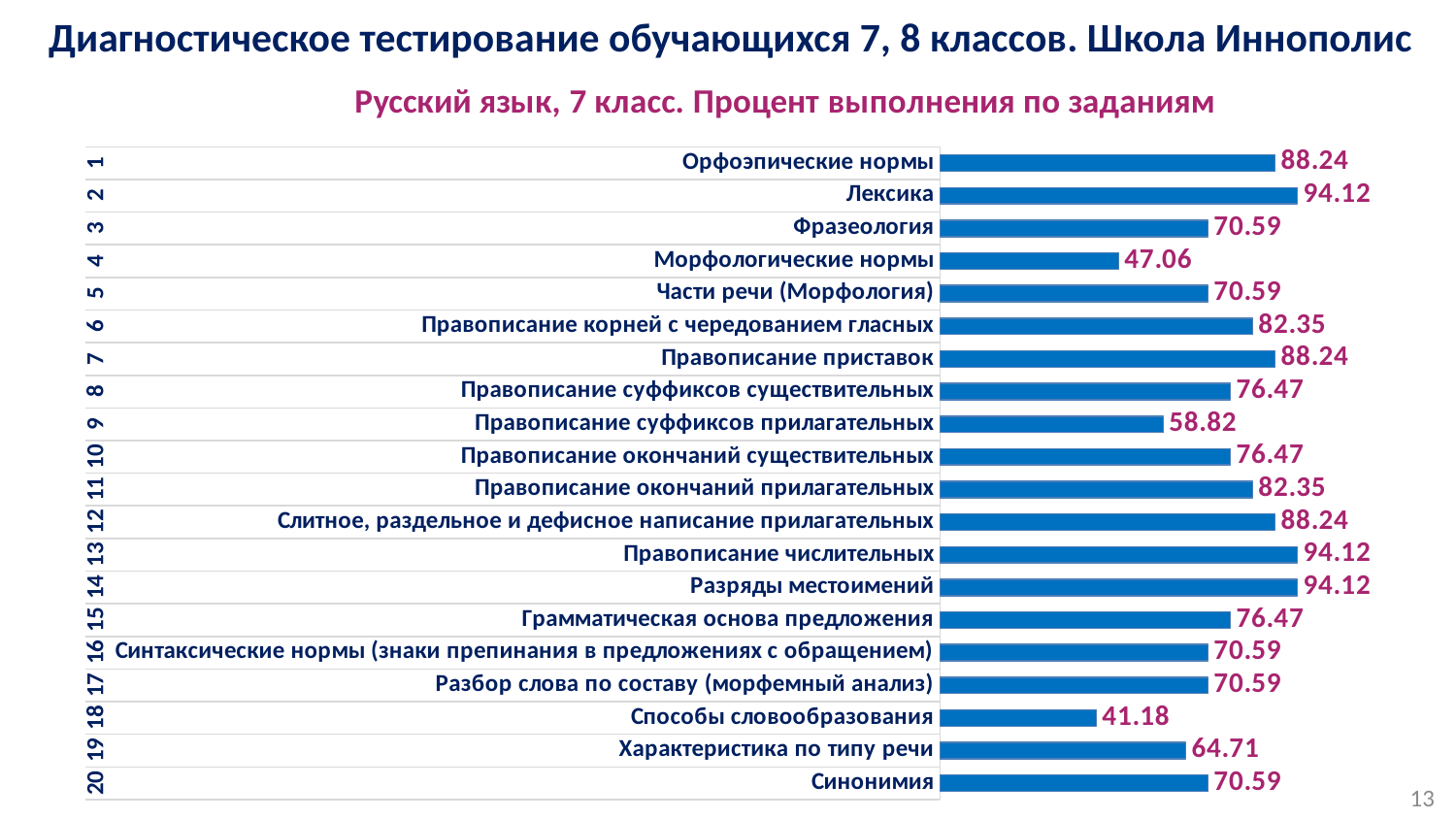
What is the value for Морфологические нормы? 47.06 How many categories are shown in the chart? 20 What is the value for Характеристика по типу речи? 64.71 What is the title of the chart? Русский язык, 7 класс. Процент выполнения по заданиям What is the highest value shown in the chart? 94.12 What is the value for Синонимия? 70.59 What is the value for Правописание суффиксов прилагательных? 58.82 What is the difference between the values for Орфоэпические нормы and Фразеология? 17.65 What is the difference between the values for Лексика and Способы словообразования? 52.94 What type of chart is shown on the slide? bar chart Which category has the lowest value? Способы словообразования Which is larger, the value for Правописание приставок or the value for Правописание суффиксов существительных? Правописание приставок